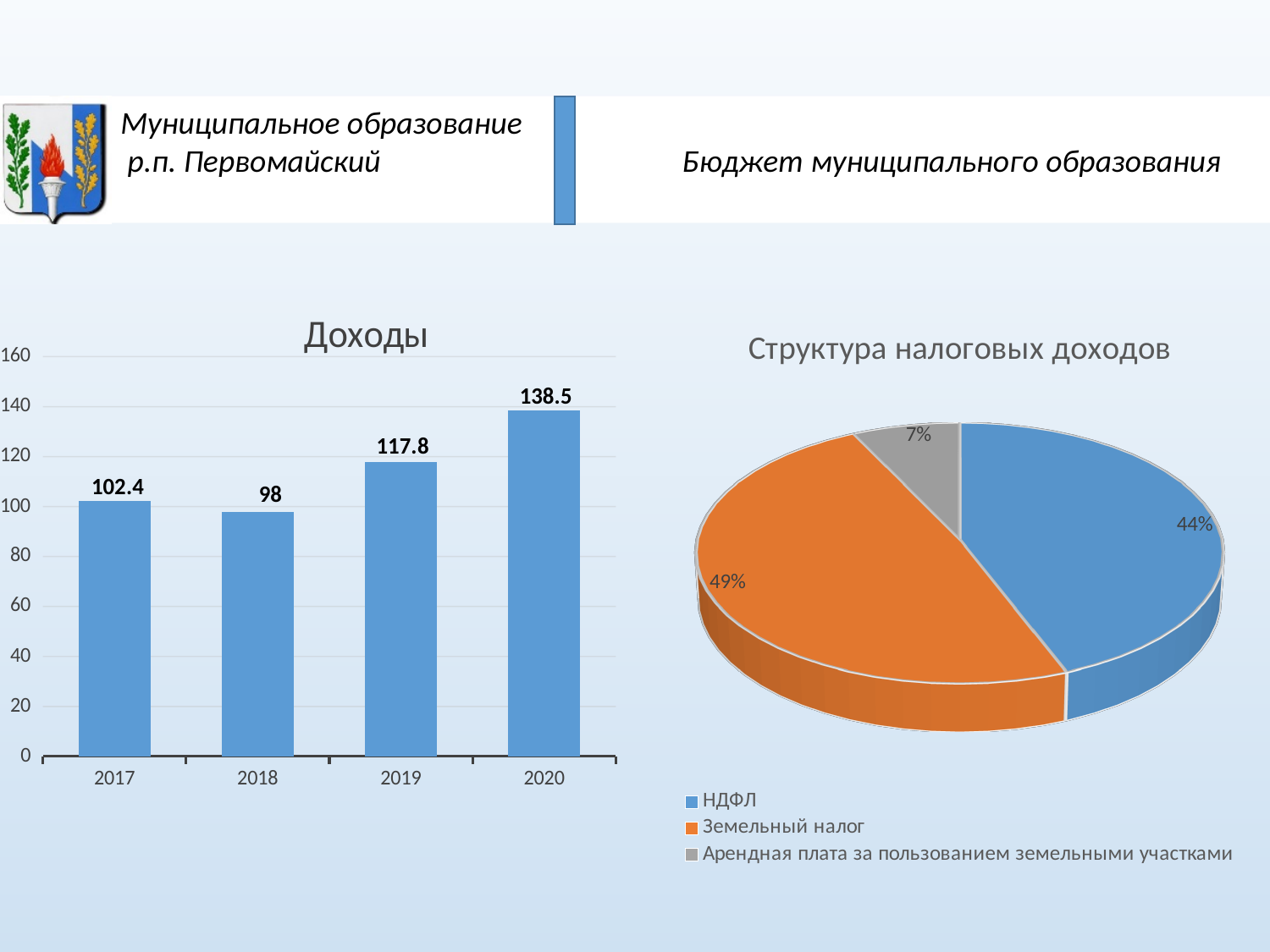
In the "Доходы" chart, what is the value for 2017? 102.4 In the "Структура налоговых доходов" chart, what share does "Земельный налог" have? 49% In the "Структура налоговых доходов" chart, which category has the smallest share? Арендная плата за пользованием земельными участками In the "Доходы" chart, which is larger, the value for 2017 or the value for 2018? 2017 In the "Доходы" chart, what is the value for 2020? 138.5 In the "Доходы" chart, which year has the highest value? 2020 What kind of chart is the "Доходы" chart? bar chart In the "Доходы" chart, what is the difference between the values for 2020 and 2019? 20.7 In the "Структура налоговых доходов" chart, what share does "НДФЛ" have? 44% In the "Доходы" chart, how many years are shown on the x axis? 4 In the "Доходы" chart, which year has the lowest value? 2018 How many entries does the legend of the "Структура налоговых доходов" chart list? 3